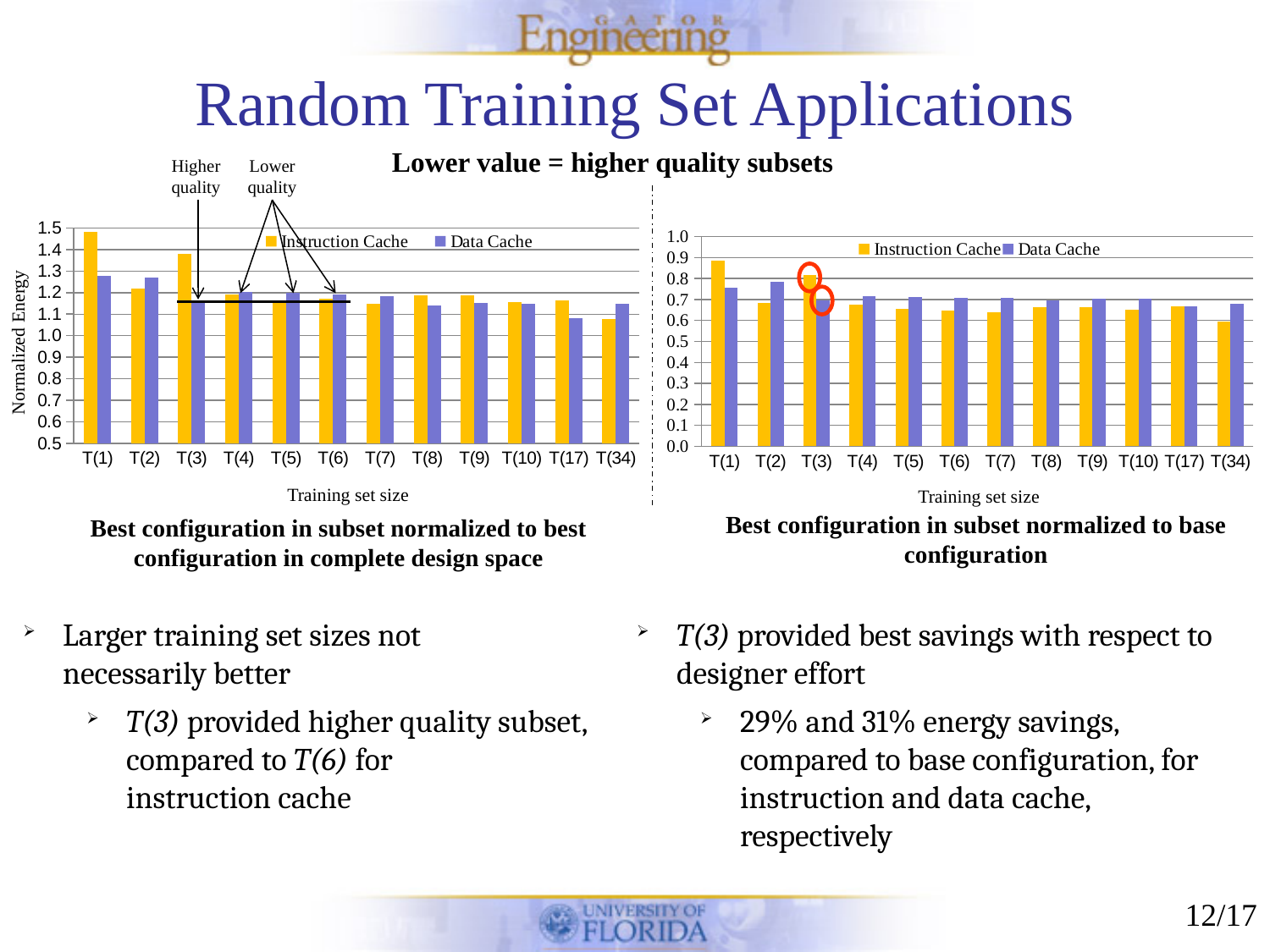
In the left chart, which training set size has the highest Instruction Cache value? T(1) How many series does the legend of the left chart list? 2 What kind of chart is the left chart, 'Best configuration in subset normalized to best configuration in complete design space'? Bar chart In the left chart, is the Data Cache value for T(17) greater or less than 1.1? less In the right chart, at T(2), which series has the larger value, Instruction Cache or Data Cache? Data Cache In the left chart, is the Instruction Cache value for T(1) greater or less than 1.4? greater In the right chart, do the Instruction Cache values overall rise or fall from T(1) to T(34)? fall In the left chart, which training set size has the lowest Data Cache value? T(17) What is the y-axis label of the left chart? Normalized Energy How many training set size categories are shown on the x axis of the right chart, 'Best configuration in subset normalized to base configuration'? 12 In the right chart, is the Instruction Cache value for T(1) greater or less than 0.8? greater In the right chart, which training set size has the highest Instruction Cache value? T(1)